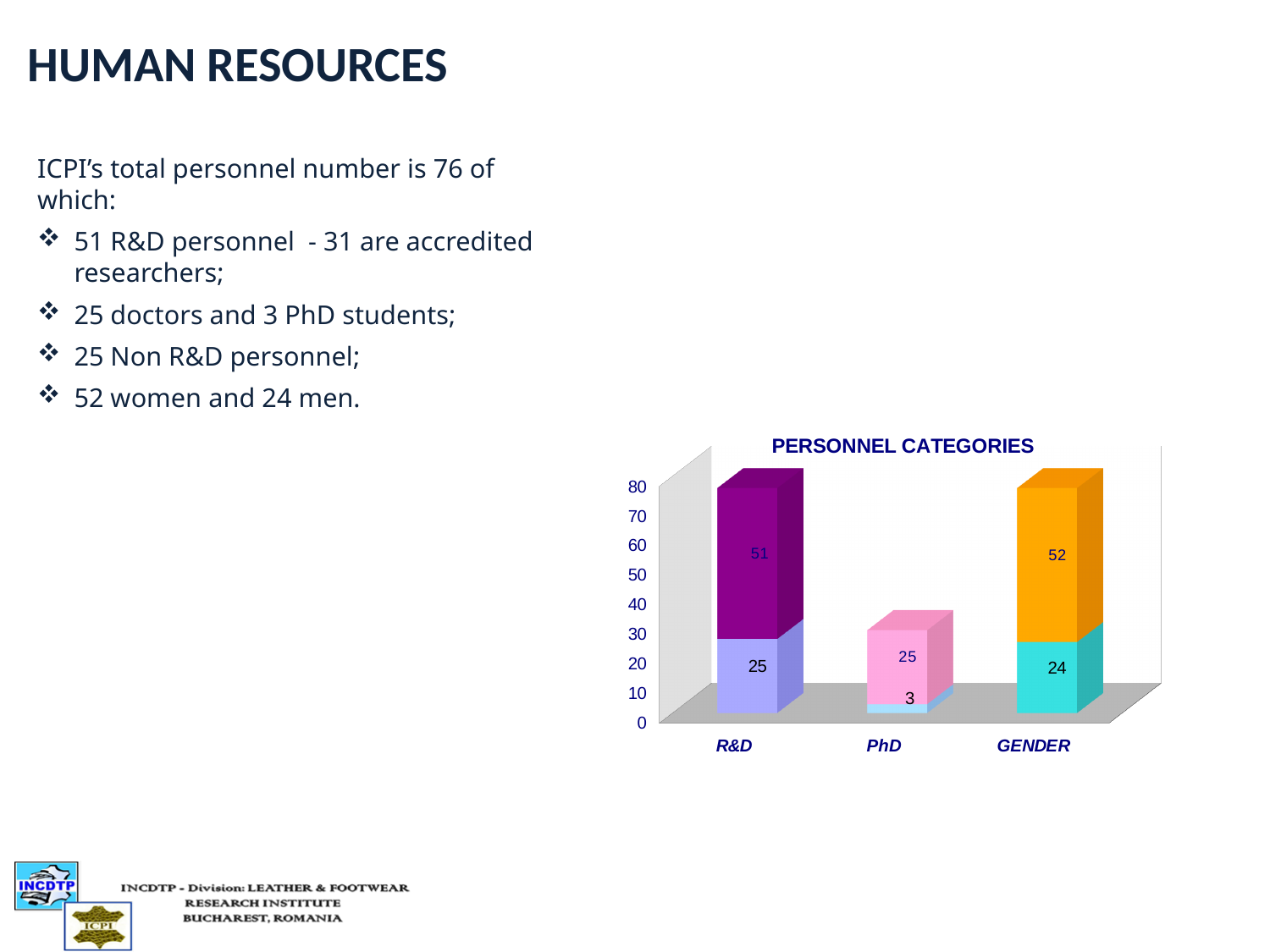
How many categories are shown on the x axis of the chart? 3 What is the value of the bottom (light blue) segment of the PhD bar? 3 Which category has the lowest stacked total? PhD What is the value of the bottom (light purple) segment of the R&D bar? 25 What kind of chart is shown on the slide? Stacked bar chart What is the total of the stacked GENDER bar? 76 What is the value of the top (purple) segment of the R&D bar? 51 What is the title of the chart? PERSONNEL CATEGORIES What is the difference between the two segments of the GENDER bar (52 and 24)? 28 What is the value of the top (orange) segment of the GENDER bar? 52 What is the total of the stacked PhD bar? 28 Which is larger: the top segment of the R&D bar or the top segment of the PhD bar? The top segment of the R&D bar